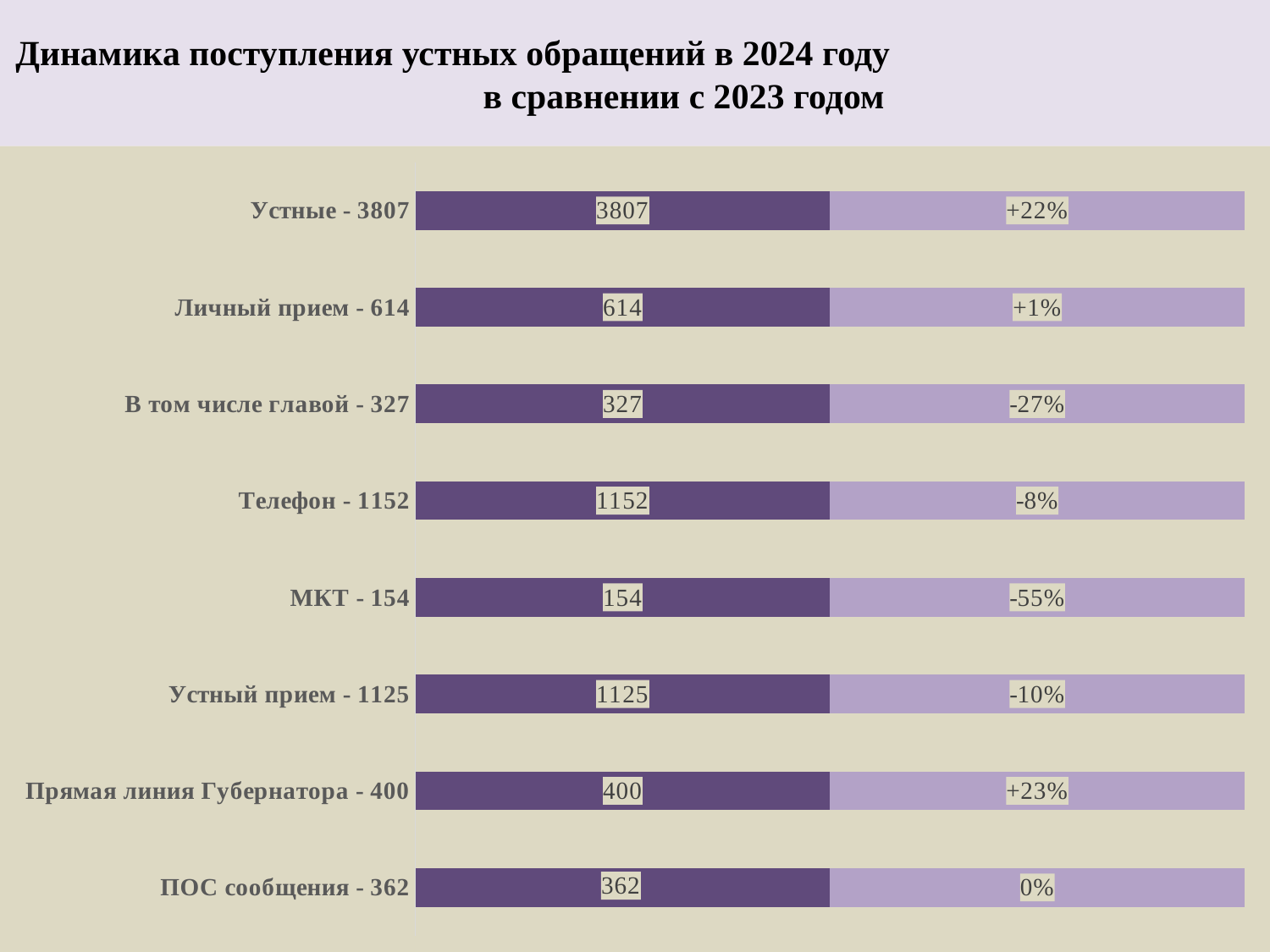
What is the difference between the values for "Телефон" and "Устный прием"? 27 What is the title of the slide? Динамика поступления устных обращений в 2024 году в сравнении с 2023 годом What is the value shown for "ПОС сообщения"? 362 What is the value shown for "Телефон"? 1152 What percentage change is shown for "Личный прием"? +1% What percentage change is shown for "МКТ"? -55% What percentage change is shown for "Прямая линия Губернатора"? +23% How many categories are shown in the chart? 8 Which category has the lowest value? МКТ Which is larger, the value for "Личный прием" or the value for "Прямая линия Губернатора"? Личный прием What kind of chart is shown on the slide? Bar chart Which category has the highest value? Устные